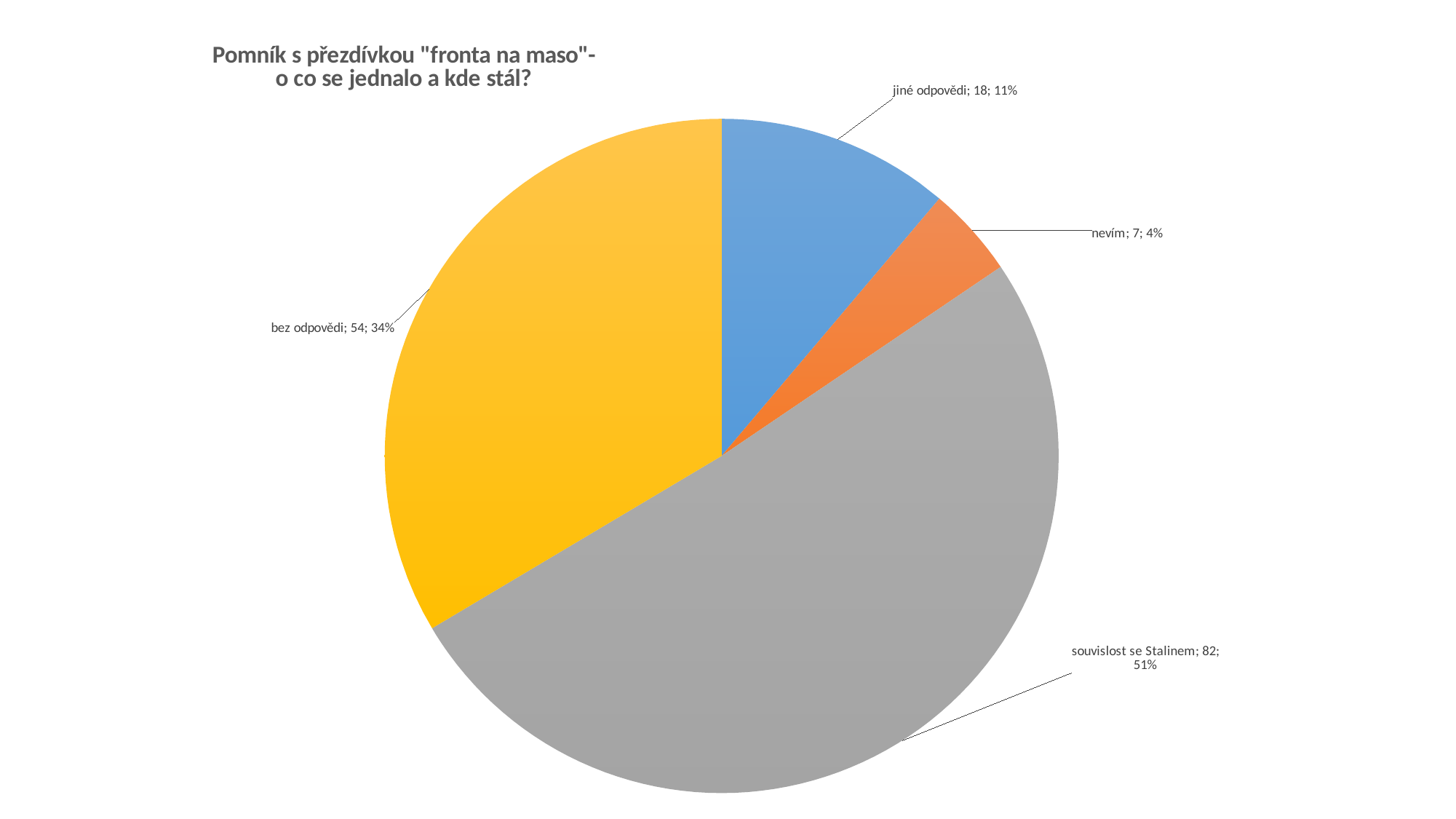
Which is larger, the value for "jiné odpovědi" or the value for "nevím"? jiné odpovědi What is the difference between the values for "souvislost se Stalinem" and "bez odpovědi"? 28 Which category has the smallest slice? nevím What is the value for "bez odpovědi"? 54 Which category has the largest slice? souvislost se Stalinem What share of the pie does "souvislost se Stalinem" represent? 51% What share of the pie does "jiné odpovědi" represent? 11% What is the value for "nevím"? 7 How many slices does the pie chart have? 4 What is the title of the chart? Pomník s přezdívkou "fronta na maso"- o co se jednalo a kde stál? What kind of chart is shown on the slide? pie chart What is the value for "souvislost se Stalinem"? 82